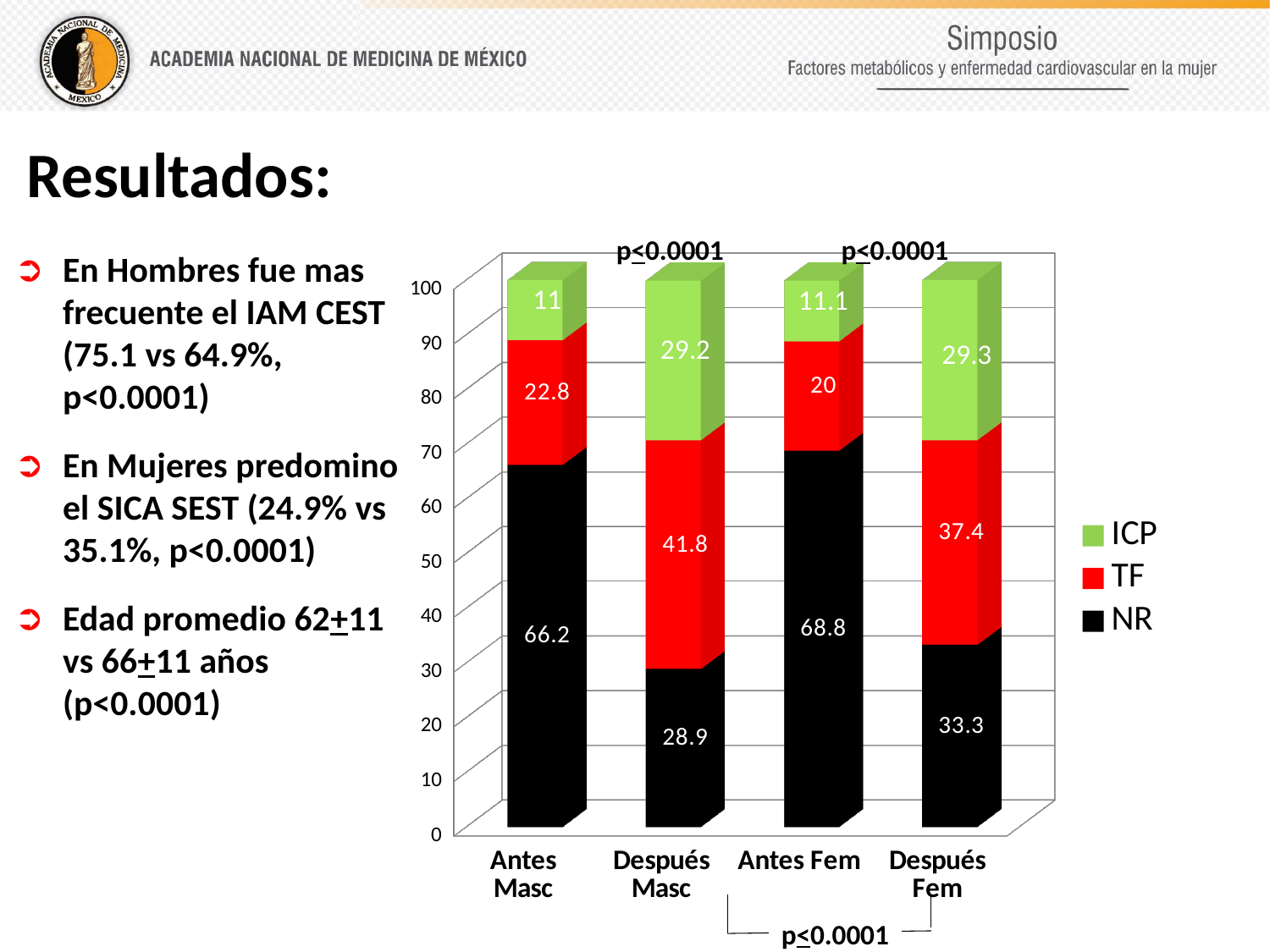
What is the NR value for Antes Masc? 66.2 What is the ICP value for Después Fem? 29.3 How many categories are shown on the x axis? 4 What is the TF value for Antes Fem? 20 What is the difference between the NR values for Antes Masc and Después Masc? 37.3 What kind of chart is shown? Stacked bar chart Which is larger, the TF value for Después Masc or the TF value for Después Fem? Después Masc What is the TF value for Después Masc? 41.8 How many series does the legend list? 3 Which category has the lowest ICP value? Antes Masc Which category has the highest NR value? Antes Fem What is the total of the stacked bar for Antes Masc? 100